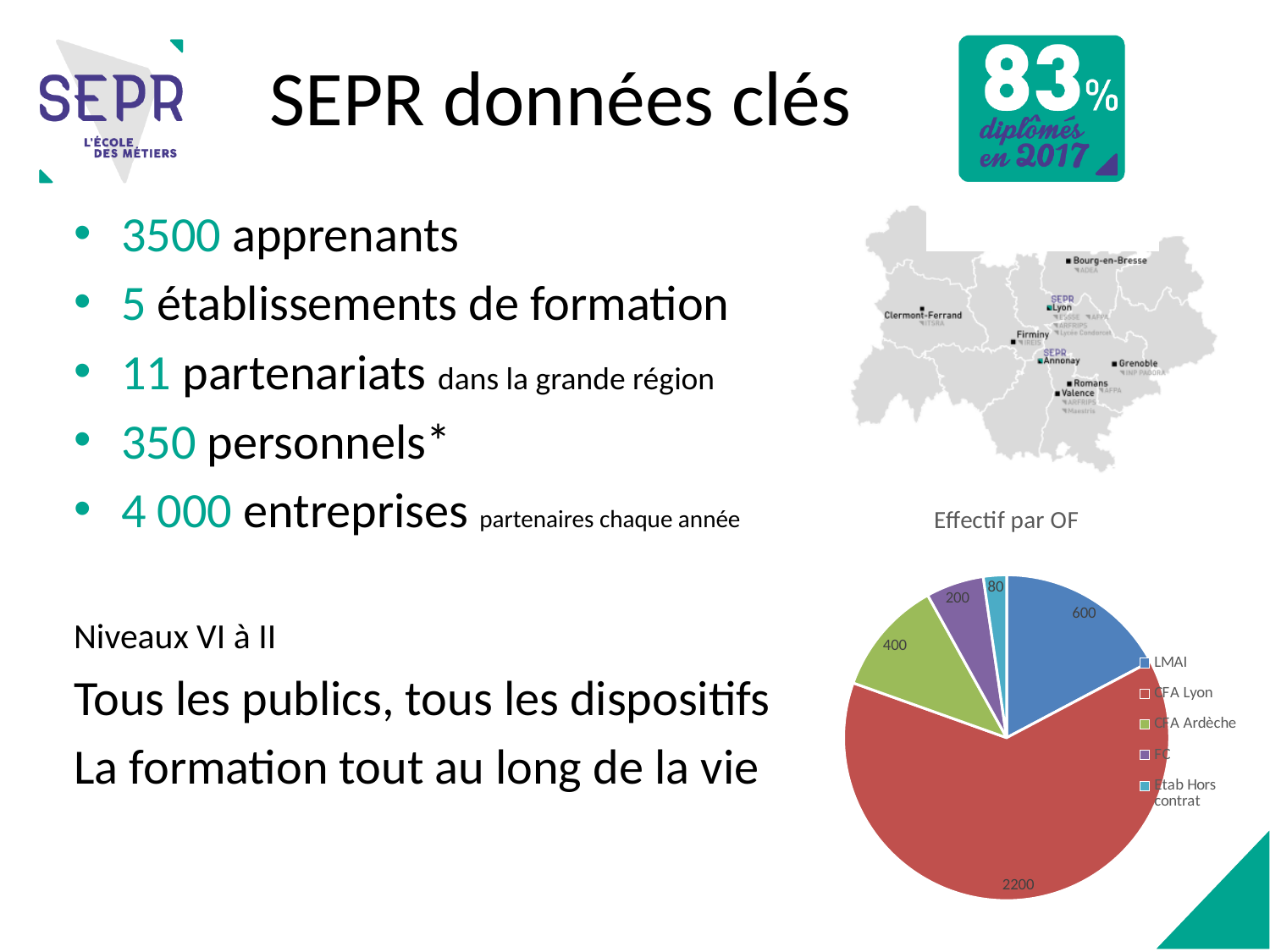
In the "Effectif par OF" pie chart, which is larger: CFA Ardèche or FC? CFA Ardèche Which category has the smallest slice in the "Effectif par OF" pie chart? Etab Hors contrat In the "Effectif par OF" pie chart, what is the value for CFA Ardèche? 400 How many categories does the "Effectif par OF" pie chart show? 5 What is the title of the pie chart on the slide? Effectif par OF In the "Effectif par OF" pie chart, what is the value for Etab Hors contrat? 80 In the "Effectif par OF" pie chart, what is the value for LMAI? 600 What is the total of all slices in the "Effectif par OF" pie chart? 3480 In the "Effectif par OF" pie chart, what is the difference between the values for CFA Lyon and LMAI? 1600 What kind of chart is shown under the title "Effectif par OF"? pie chart Which category has the largest slice in the "Effectif par OF" pie chart? CFA Lyon In the "Effectif par OF" pie chart, what is the value for CFA Lyon? 2200